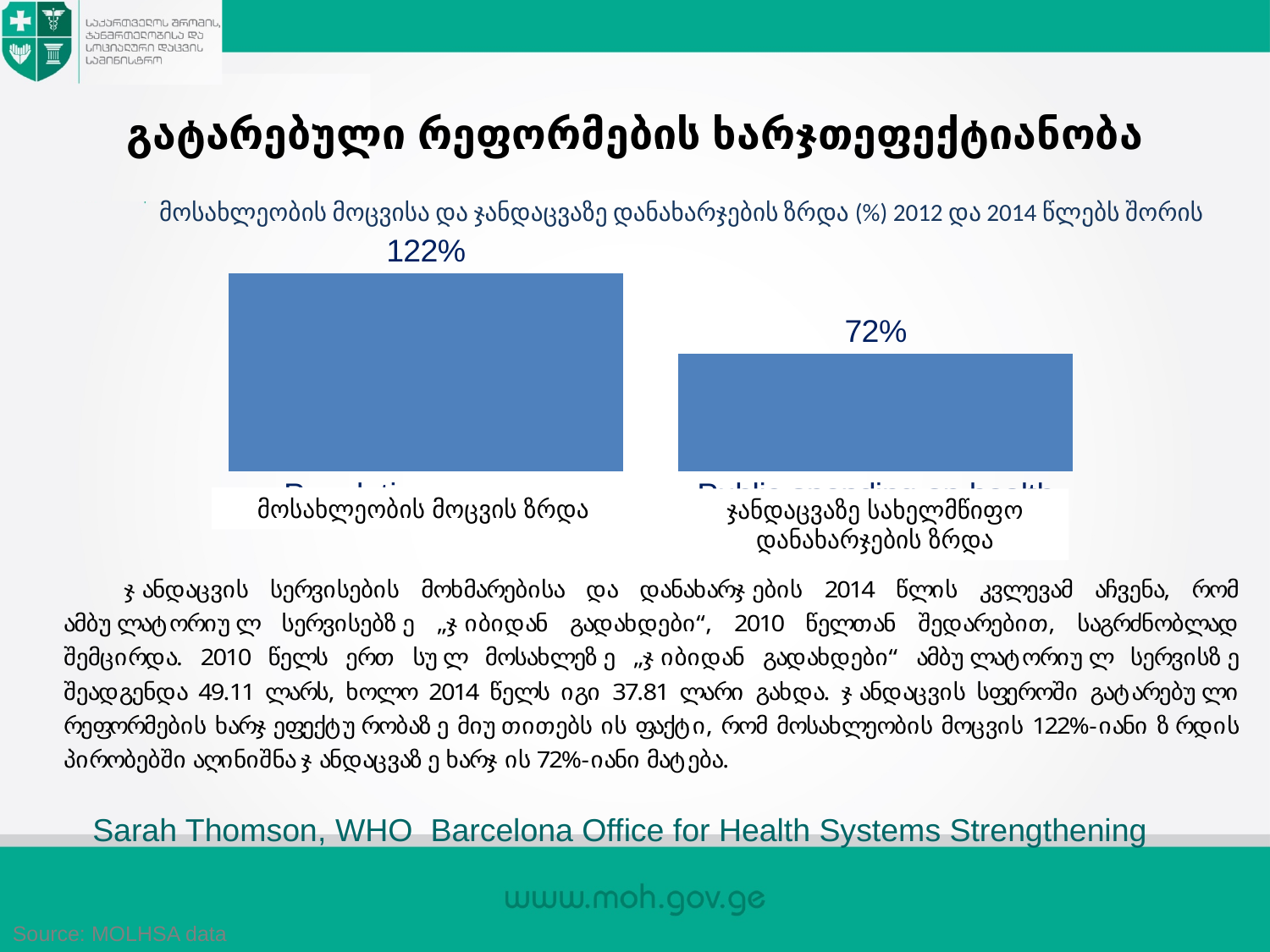
How many bars are shown in the chart? 2 What value is shown for ჯანდაცვაზე სახელმწიფო დანახარჯების ზრდა? 72% Which category has the highest value? მოსახლეობის მოცვის ზრდა Which category has the lowest value? ჯანდაცვაზე სახელმწიფო დანახარჯების ზრდა What is the difference between the value for მოსახლეობის მოცვის ზრდა and the value for ჯანდაცვაზე სახელმწიფო დანახარჯების ზრდა? 50 percentage points What value is shown for მოსახლეობის მოცვის ზრდა? 122% Which is larger: the value for მოსახლეობის მოცვის ზრდა or the value for ჯანდაცვაზე სახელმწიფო დანახარჯების ზრდა? მოსახლეობის მოცვის ზრდა What kind of chart is shown on the slide? Bar chart What colour are the bars in the chart? Blue What is the title of the chart? მოსახლეობის მოცვისა და ჯანდაცვაზე დანახარჯების ზრდა (%) 2012 და 2014 წლებს შორის